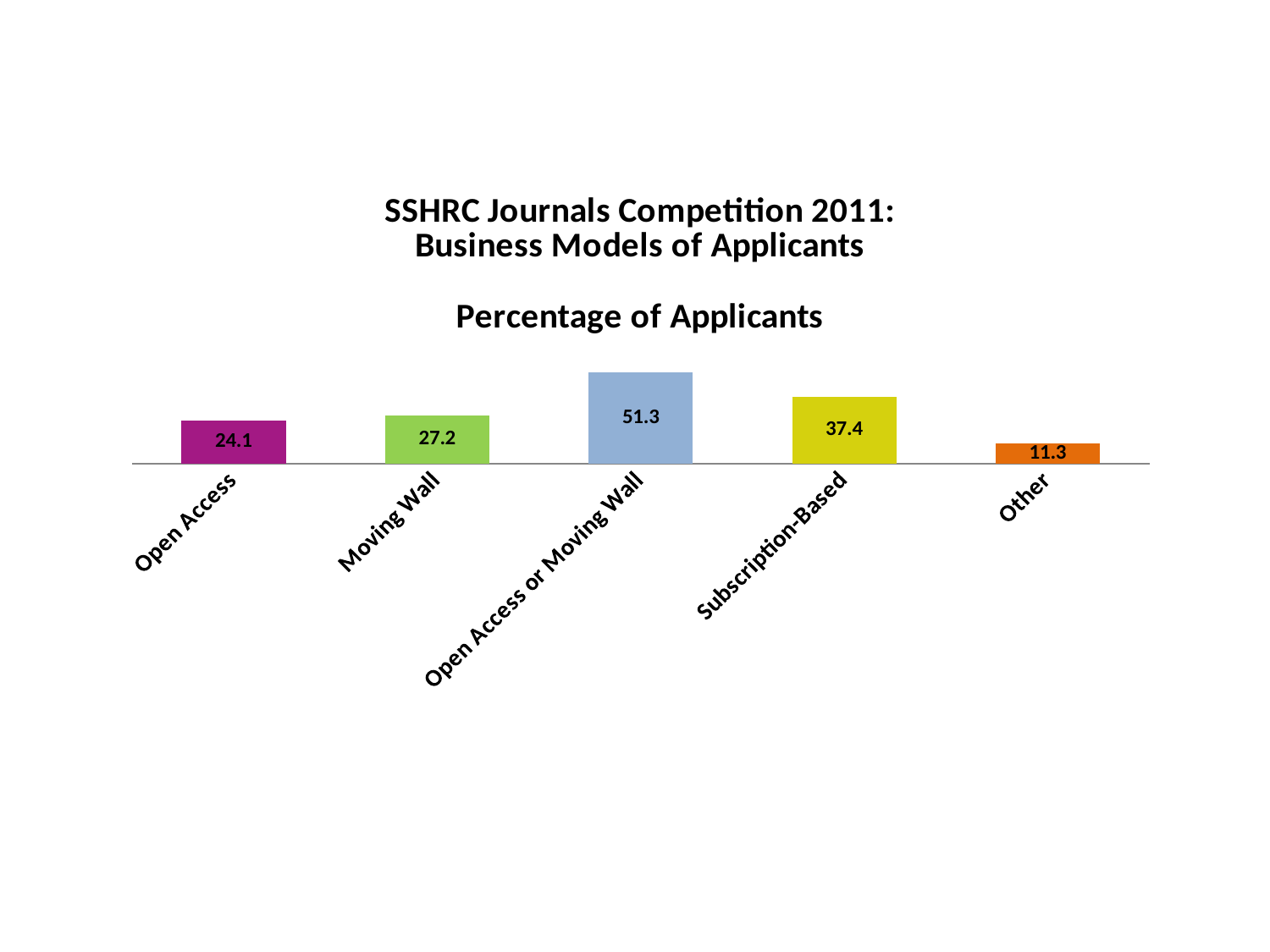
Which category has the lowest value? Other What is the difference between the values for Moving Wall and Open Access? 3.1 How many categories are shown in the chart? 5 What is the value for Open Access? 24.1 What is the difference between the values for Open Access or Moving Wall and Subscription-Based? 13.9 What is the value for Other? 11.3 What is the value for Subscription-Based? 37.4 Which is larger, the value for Moving Wall or the value for Subscription-Based? Subscription-Based Which category has the highest value? Open Access or Moving Wall What is the name of the series plotted in the chart? Percentage of Applicants What is the title of the chart? SSHRC Journals Competition 2011: Business Models of Applicants What kind of chart is shown on the slide? Bar chart